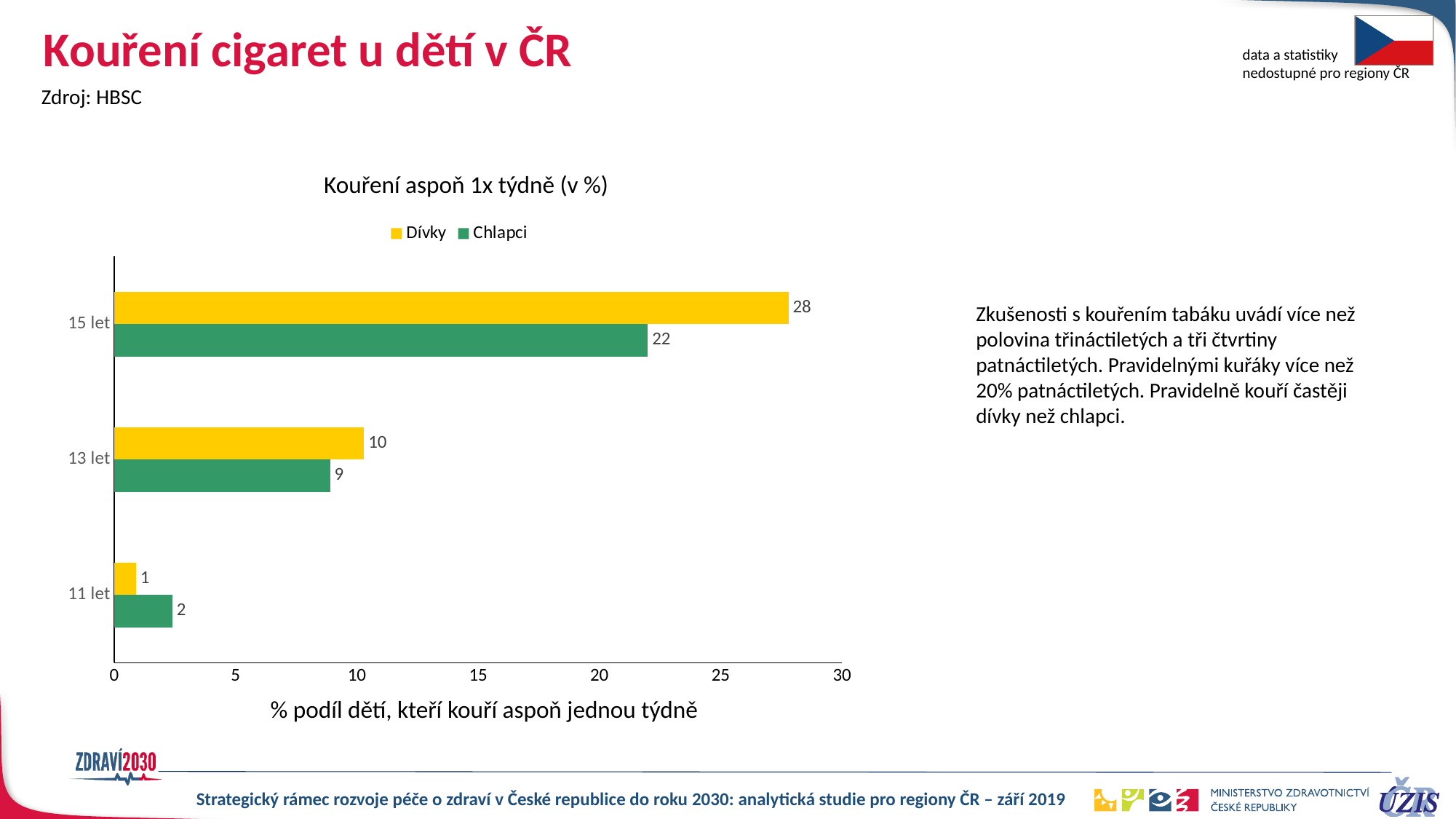
Which age group has the lowest value for Chlapci? 11 let What is the value for Chlapci at 13 let? 9 What kind of chart is shown? bar chart Which age group has the highest value for Dívky? 15 let How many age groups are shown on the chart? 3 How many series does the legend list? 2 Is the value for Chlapci at 15 let greater or less than 20? greater What is the difference between Dívky and Chlapci at 15 let? 6 Which is larger at 11 let, Dívky or Chlapci? Chlapci What is the value for Dívky at 15 let? 28 What is the value for Chlapci at 11 let? 2 What is the title of the chart? Kouření aspoň 1x týdně (v %)